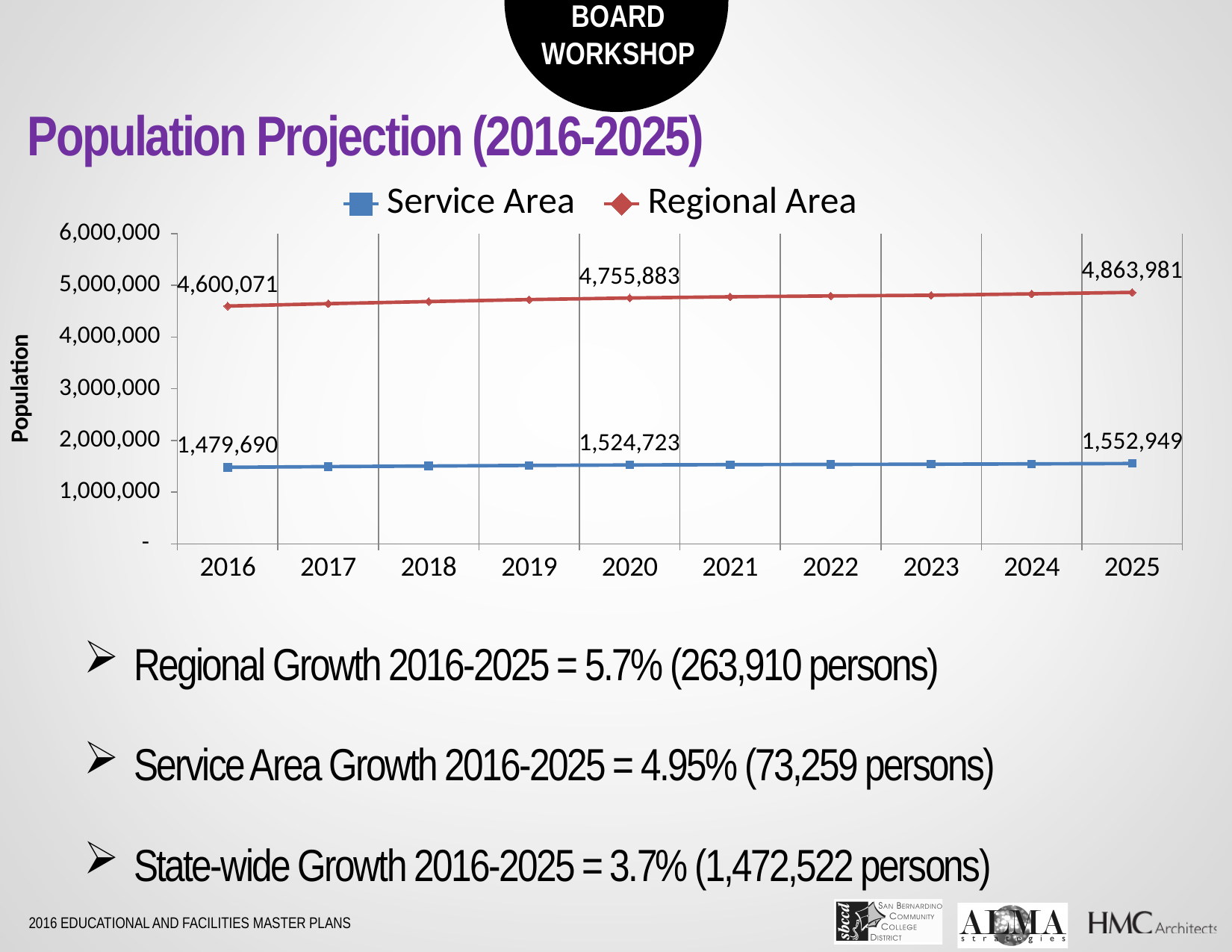
What is the difference between the Regional Area and Service Area values in 2020? 3,231,160 Which series has the higher value in 2025, Service Area or Regional Area? Regional Area How many years are plotted along the x axis? 10 How many series does the legend list? 2 What is the Regional Area population value shown for 2016? 4,600,071 What is the difference between the Regional Area values for 2025 and 2016? 263,910 What is the Service Area population value shown for 2020? 1,524,723 What is the Regional Area population value shown for 2020? 4,755,883 Does the Regional Area line rise or fall from 2016 to 2025? Rise What type of chart is shown on the slide? Line chart Is the Service Area value for 2022 greater or less than 2,000,000? less What is the Service Area population value shown for 2025? 1,552,949